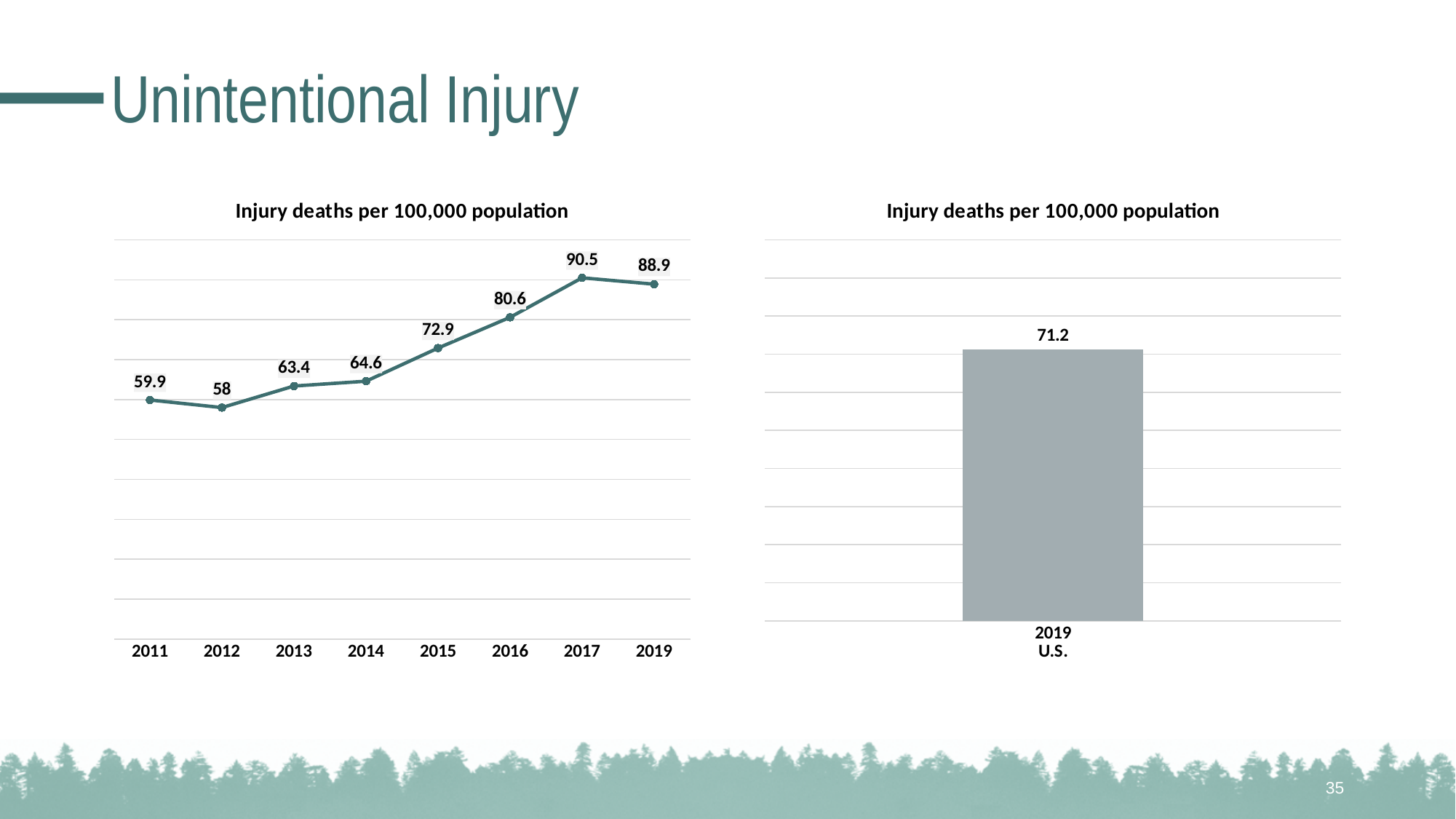
In the left chart, which is larger, the value for 2016 or the value for 2019? 2019 In the left chart, what is the value for 2012? 58 In the left chart, what is the value for 2015? 72.9 What kind of chart is the left chart? line chart How many data points are plotted in the left chart? 8 In the left chart, do the values generally rise or fall from 2011 to 2017? rise In the left chart, what is the difference between the values for 2017 and 2011? 30.6 What kind of chart is the right chart? bar chart In the left chart, which year has the lowest value? 2012 In the right chart, what is the value for 2019 U.S.? 71.2 In the left chart, which year has the highest value? 2017 What is the title of the right chart? Injury deaths per 100,000 population